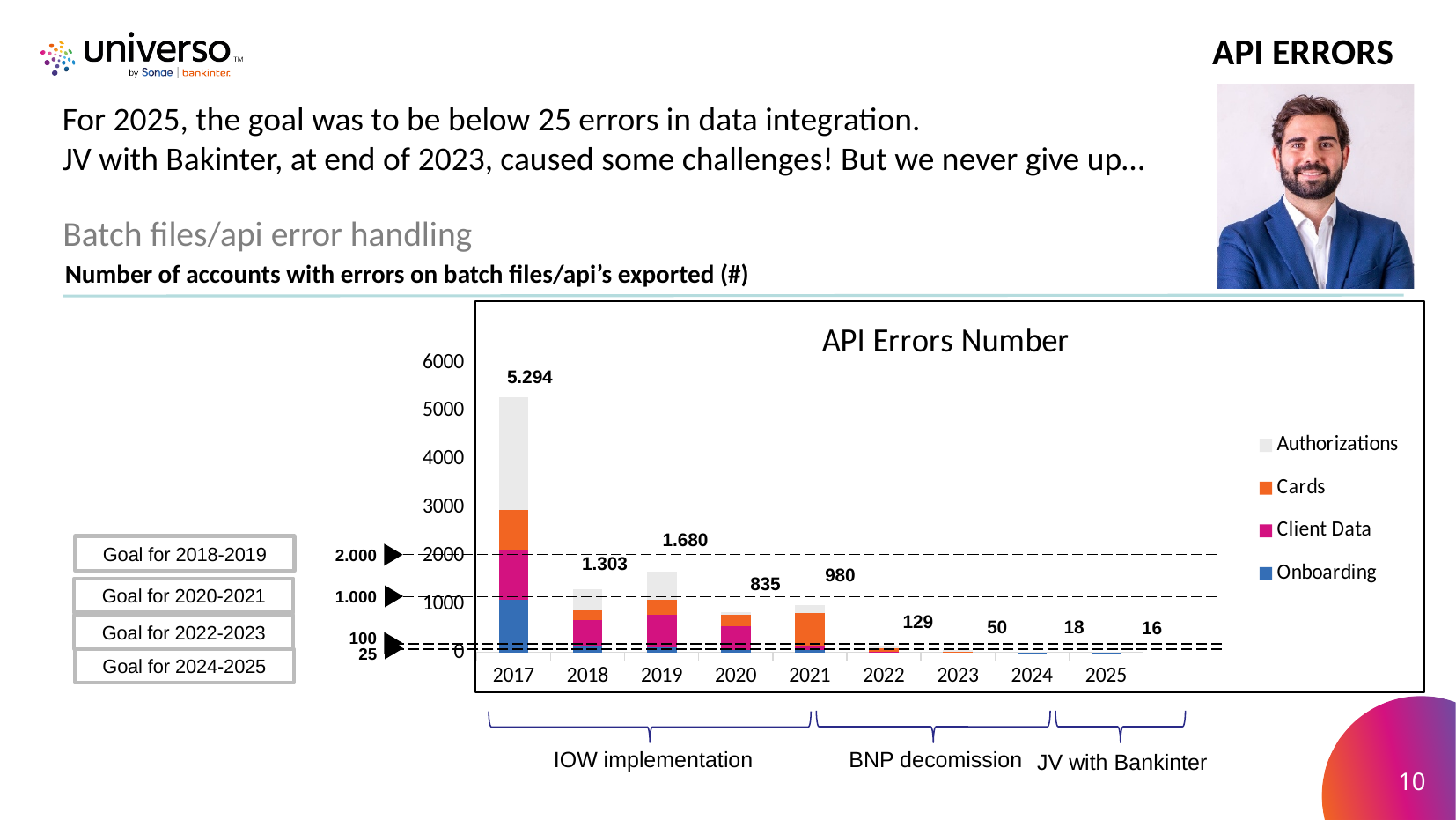
How many years are shown on the x axis of the API Errors Number chart? 9 Which year has the lowest total number of API errors? 2025 What is the total number of API errors shown for 2017? 5.294 What is the total number of API errors shown for 2022? 129 What is the total number of API errors shown for 2025? 16 What is the total number of API errors shown for 2019? 1.680 Which year has more total API errors, 2020 or 2021? 2021 Which year has the highest total number of API errors? 2017 What kind of chart is the API Errors Number chart? Stacked bar chart What is the difference between the total API errors in 2019 and 2018? 377 What is the difference between the total API errors in 2021 and 2020? 145 How many series does the legend of the API Errors Number chart list? 4